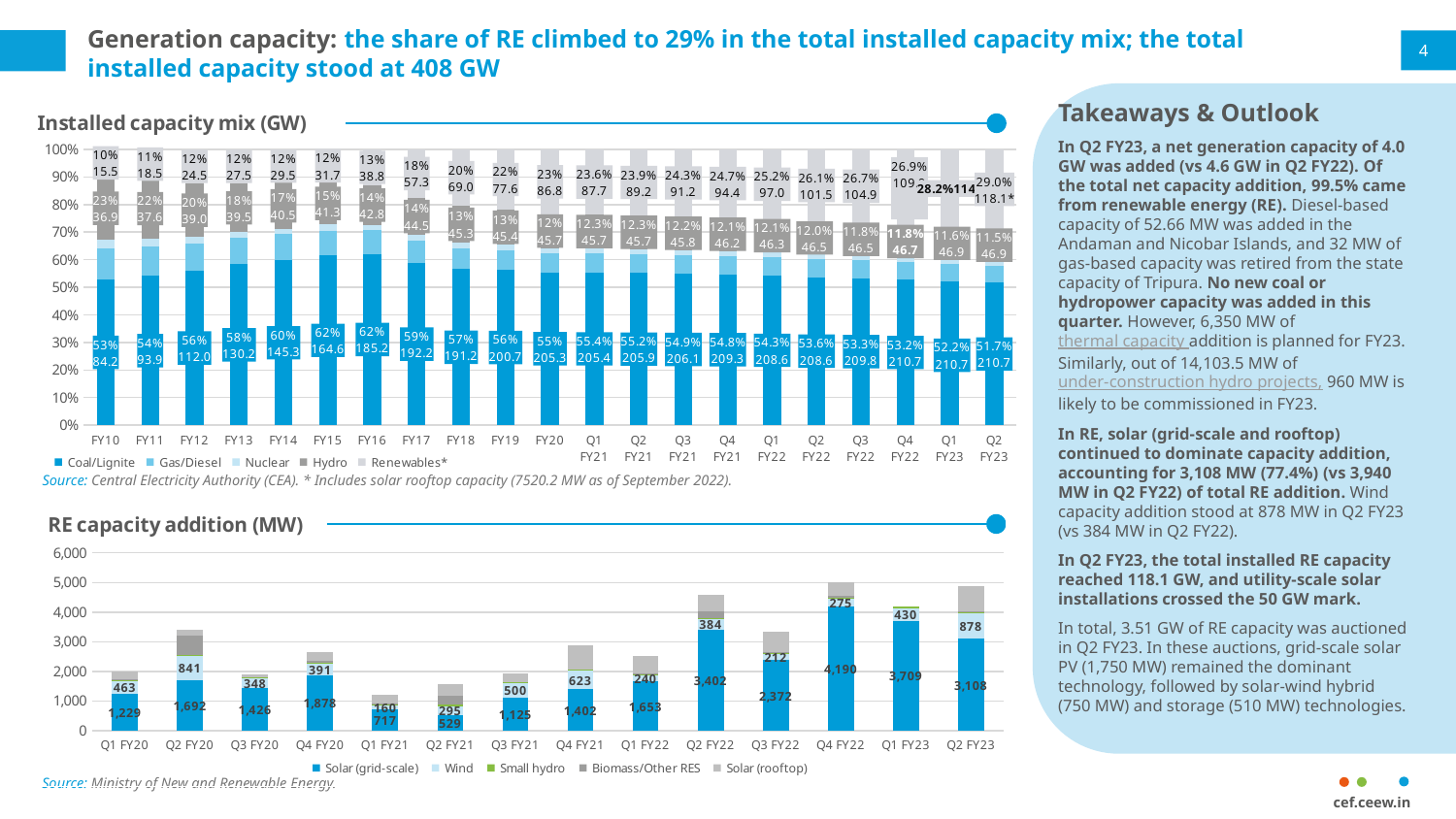
In the "Installed capacity mix (GW)" chart, which is larger, the Coal/Lignite value for FY16 or for FY17? FY17 What kind of chart is the "RE capacity addition (MW)" chart? bar chart In the "Installed capacity mix (GW)" chart, does the Renewables share rise or fall from FY10 to Q2 FY23? rise In the "RE capacity addition (MW)" chart, what is the Wind value for Q2 FY23? 878 How many series does the legend of the "Installed capacity mix (GW)" chart list? 5 In the "RE capacity addition (MW)" chart, what is the difference between the Solar (grid-scale) values for Q1 FY23 and Q2 FY23? 601 How many quarters are shown on the x axis of the "RE capacity addition (MW)" chart? 14 In the "Installed capacity mix (GW)" chart, what is the Coal/Lignite value for FY10? 84.2 In the "RE capacity addition (MW)" chart, which quarter has the lowest Wind addition? Q1 FY21 In the "RE capacity addition (MW)" chart, which quarter has the highest Solar (grid-scale) addition? Q4 FY22 In the "Installed capacity mix (GW)" chart, what percentage share do Renewables have in Q2 FY23? 29.0% In the "RE capacity addition (MW)" chart, what is the Solar (grid-scale) value for Q4 FY22? 4,190